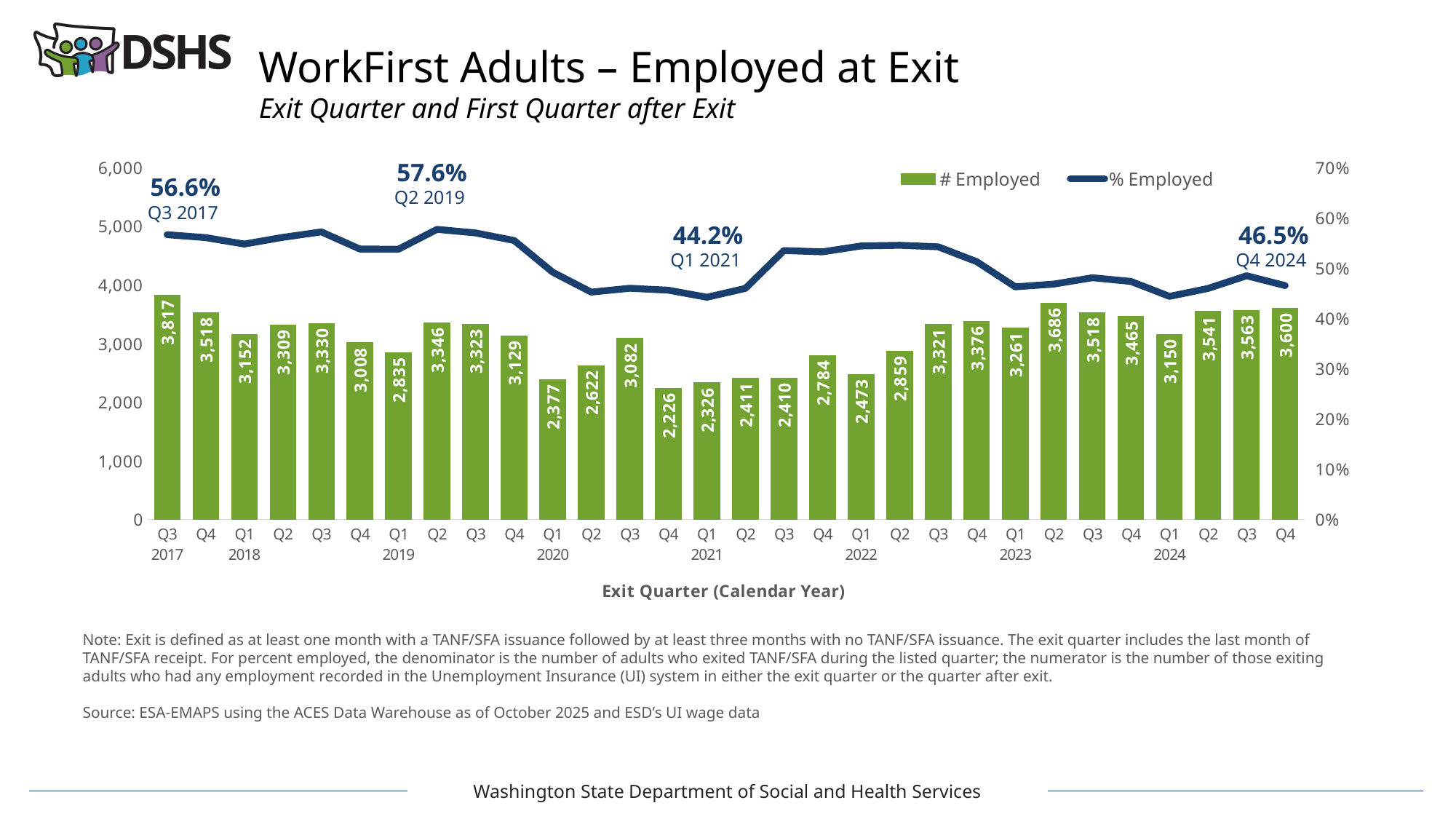
How many exit quarters are shown on the x axis? 30 What is the number employed for Q3 2017? 3,817 Is the % Employed value for Q2 2020 greater or less than 50%? less What is the number employed for Q4 2020? 2,226 Which exit quarter has the highest number employed? Q3 2017 What is the x-axis title of the chart? Exit Quarter (Calendar Year) Which exit quarter has the lowest number employed? Q4 2020 What is the difference in number employed between Q4 2024 and Q3 2024? 37 What is the % Employed value labeled for Q2 2019? 57.6% Which has a larger number employed, Q2 2023 or Q3 2023? Q2 2023 What is the % Employed value labeled for Q4 2024? 46.5% How many series does the legend list? 2